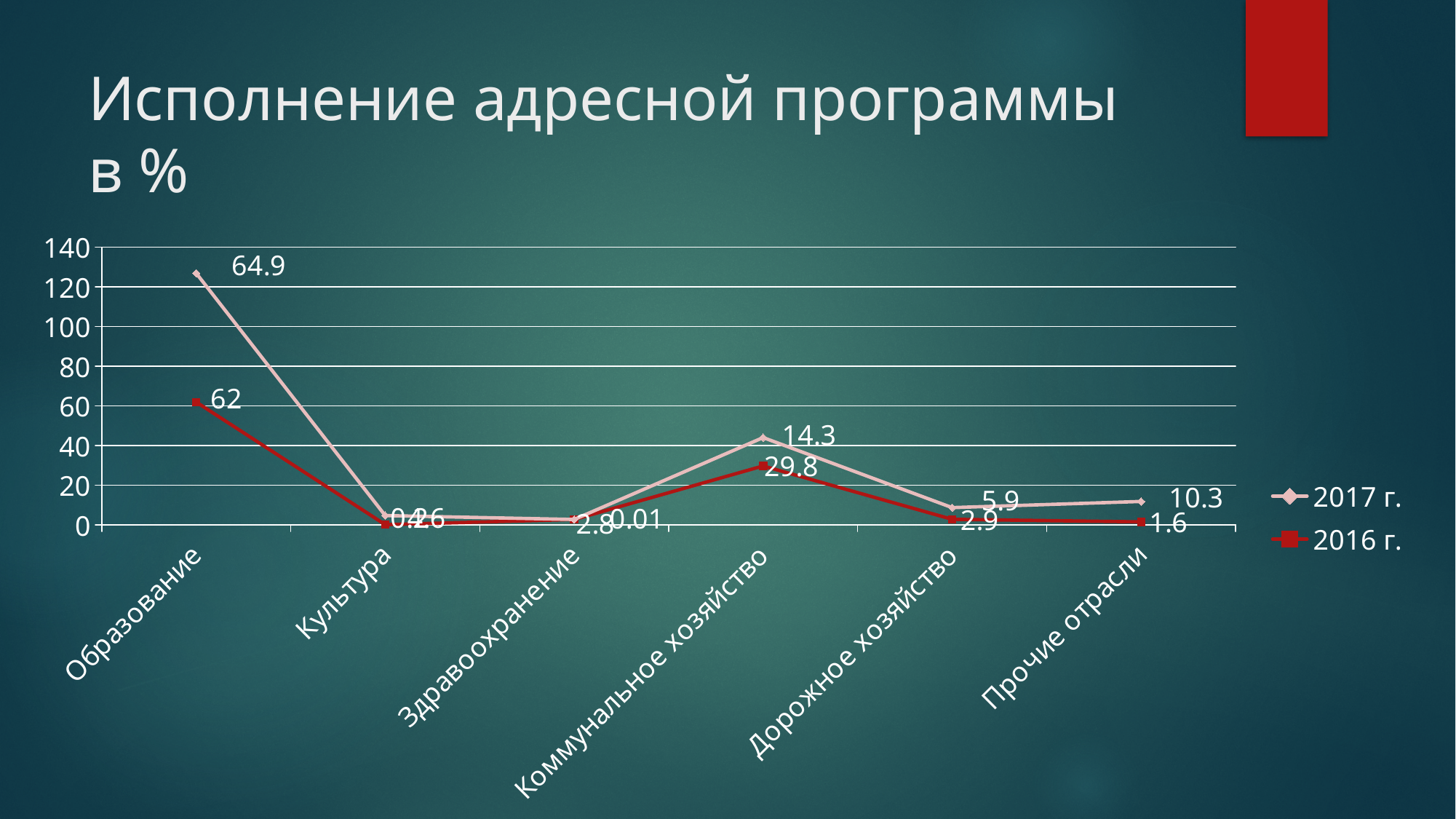
Which category has the highest value in the 2016 г. series? Образование What is the title of the chart? Исполнение адресной программы в % For Прочие отрасли, which series has the larger value, 2017 г. or 2016 г.? 2017 г. How many categories are shown on the x axis? 6 How many series does the legend list? 2 What is the value for Образование in the 2016 г. series? 62 What type of chart is shown on the slide? line chart What is the difference between the 2017 г. and 2016 г. values for Дорожное хозяйство? 3 What is the value for Дорожное хозяйство in the 2016 г. series? 2.9 What is the value for Образование in the 2017 г. series? 64.9 What is the value for Прочие отрасли in the 2017 г. series? 10.3 What is the value for Коммунальное хозяйство in the 2016 г. series? 29.8